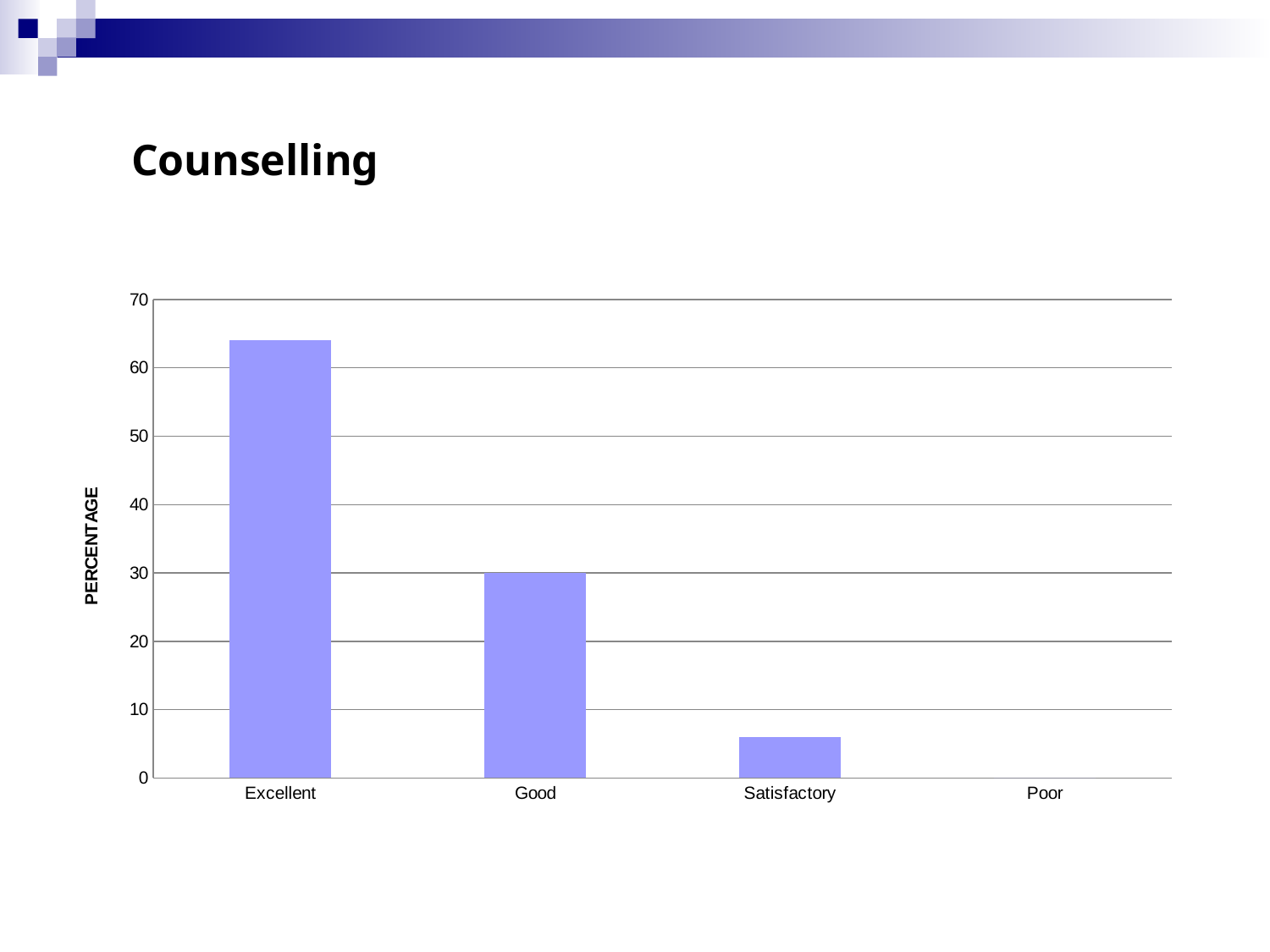
Is the value for Excellent greater or less than 60? greater What is the title of the slide containing the chart? Counselling What kind of chart is shown on the slide? bar chart Which category has the lowest percentage? Poor What is the label on the vertical axis of the chart? PERCENTAGE Which is larger, the value for Good or the value for Satisfactory? Good Do the values rise or fall moving from Excellent to Poor along the x axis? fall What is the percentage for Poor? 0 Is the value for Satisfactory greater or less than 10? less What is the percentage for Good? 30 Which category has the highest percentage? Excellent How many categories are shown on the x axis of the chart? 4